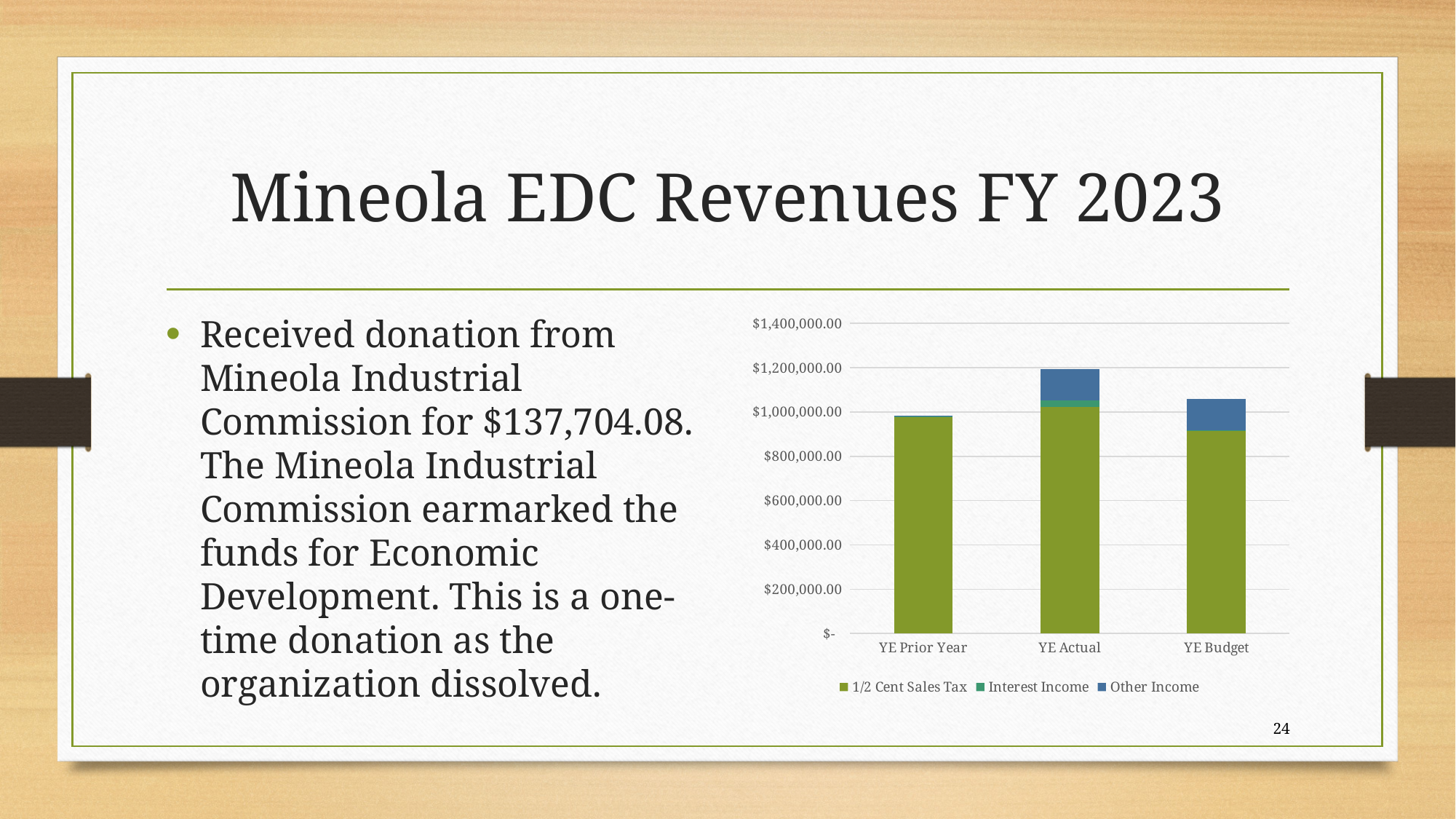
What kind of chart is shown on the slide? Stacked bar chart Which series in the legend is shown in green (the bottom segment of each bar)? 1/2 Cent Sales Tax Is the total value for YE Actual greater or less than $1,000,000.00? greater Is the total value for YE Prior Year greater or less than $1,200,000.00? less Which has the larger 1/2 Cent Sales Tax value, YE Prior Year or YE Budget? YE Prior Year How many series does the chart legend list? 3 Which category has the lowest total bar in the chart? YE Prior Year Which category has the highest total bar in the chart? YE Actual Does the total bar rise or fall from YE Prior Year to YE Actual? rise Which has the larger total bar, YE Actual or YE Budget? YE Actual How many categories are shown on the x axis of the chart? 3 Is the 1/2 Cent Sales Tax value for YE Budget greater or less than $1,000,000.00? less